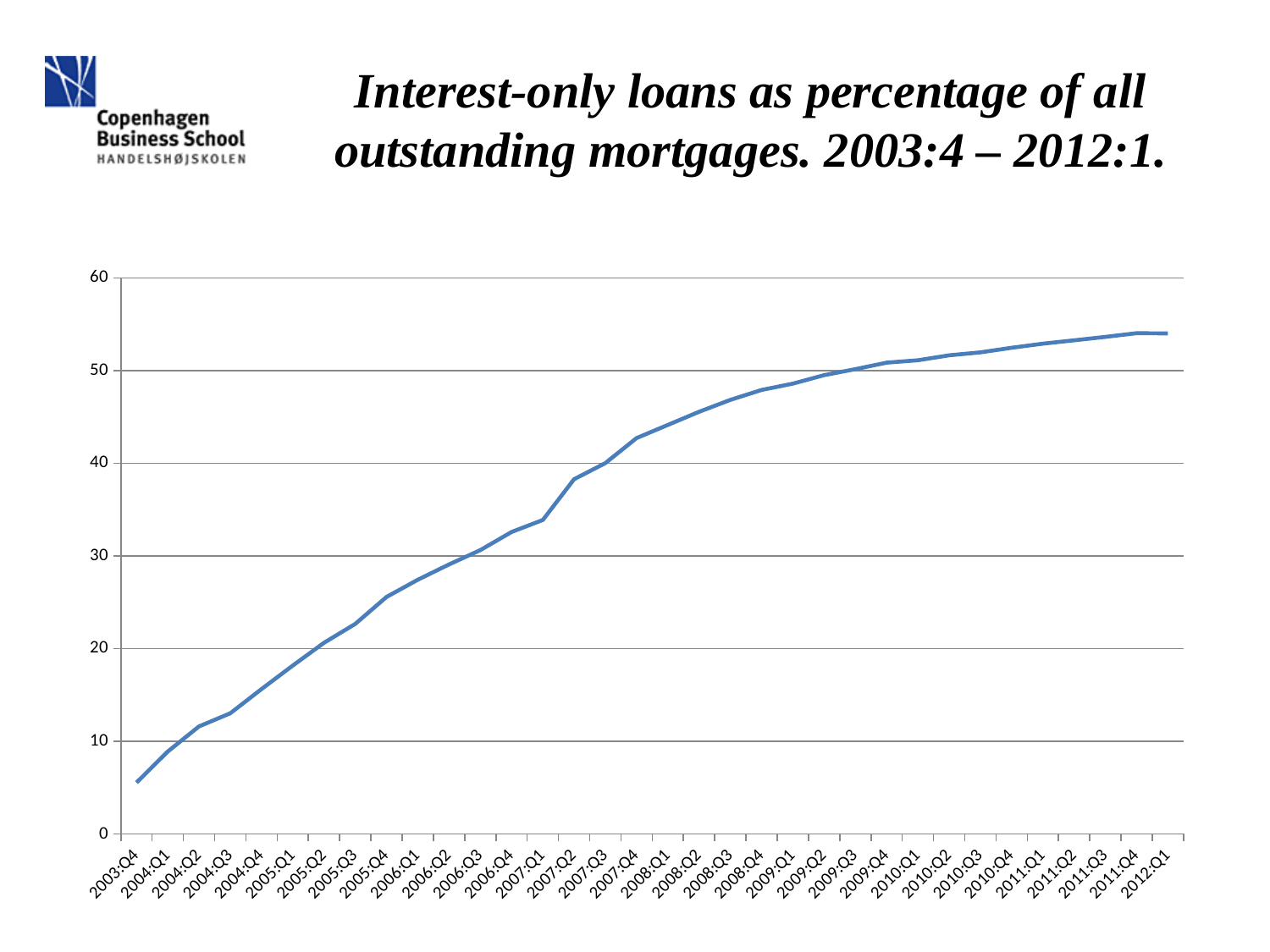
Is the value for 2005:Q4 greater or less than 20? greater How many quarters are plotted on the x axis? 34 Do the values rise or fall along the x axis from 2003:Q4 to 2012:Q1? rise Which quarter has the lowest value on the chart? 2003:Q4 Is the value for 2012:Q1 greater or less than 60? less Is the value for 2003:Q4 greater or less than 10? less Which is larger, the value for 2004:Q1 or the value for 2009:Q1? 2009:Q1 What is the title of the chart? Interest-only loans as percentage of all outstanding mortgages. 2003:4 – 2012:1. What kind of chart is shown on the slide? line chart